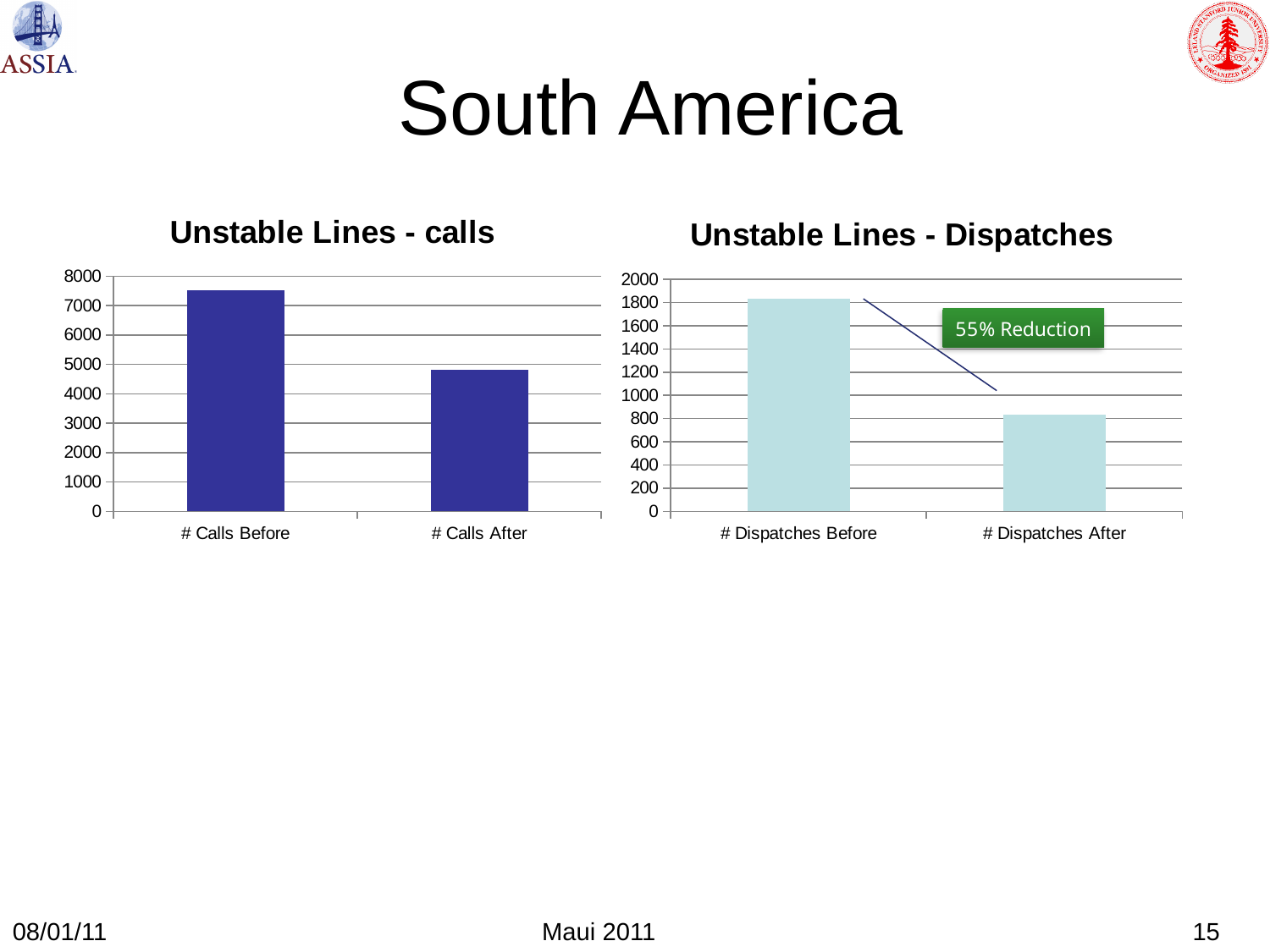
What is the title of the chart on the left side of the slide? Unstable Lines - calls In the 'Unstable Lines - calls' chart, which category has the lower value? # Calls After In the 'Unstable Lines - Dispatches' chart, which category has the higher value? # Dispatches Before In the 'Unstable Lines - calls' chart, is the value for # Calls Before greater or less than 7000? greater In the 'Unstable Lines - Dispatches' chart, do the values rise or fall from left to right? fall In the 'Unstable Lines - calls' chart, which category has the higher value? # Calls Before What type of chart is 'Unstable Lines - calls'? bar chart In the 'Unstable Lines - Dispatches' chart, is the value for # Dispatches After greater or less than 1000? less How many categories are shown in the 'Unstable Lines - calls' chart? 2 In the 'Unstable Lines - calls' chart, is the value for # Calls After greater or less than 5000? less What percentage reduction is annotated on the 'Unstable Lines - Dispatches' chart? 55% Reduction